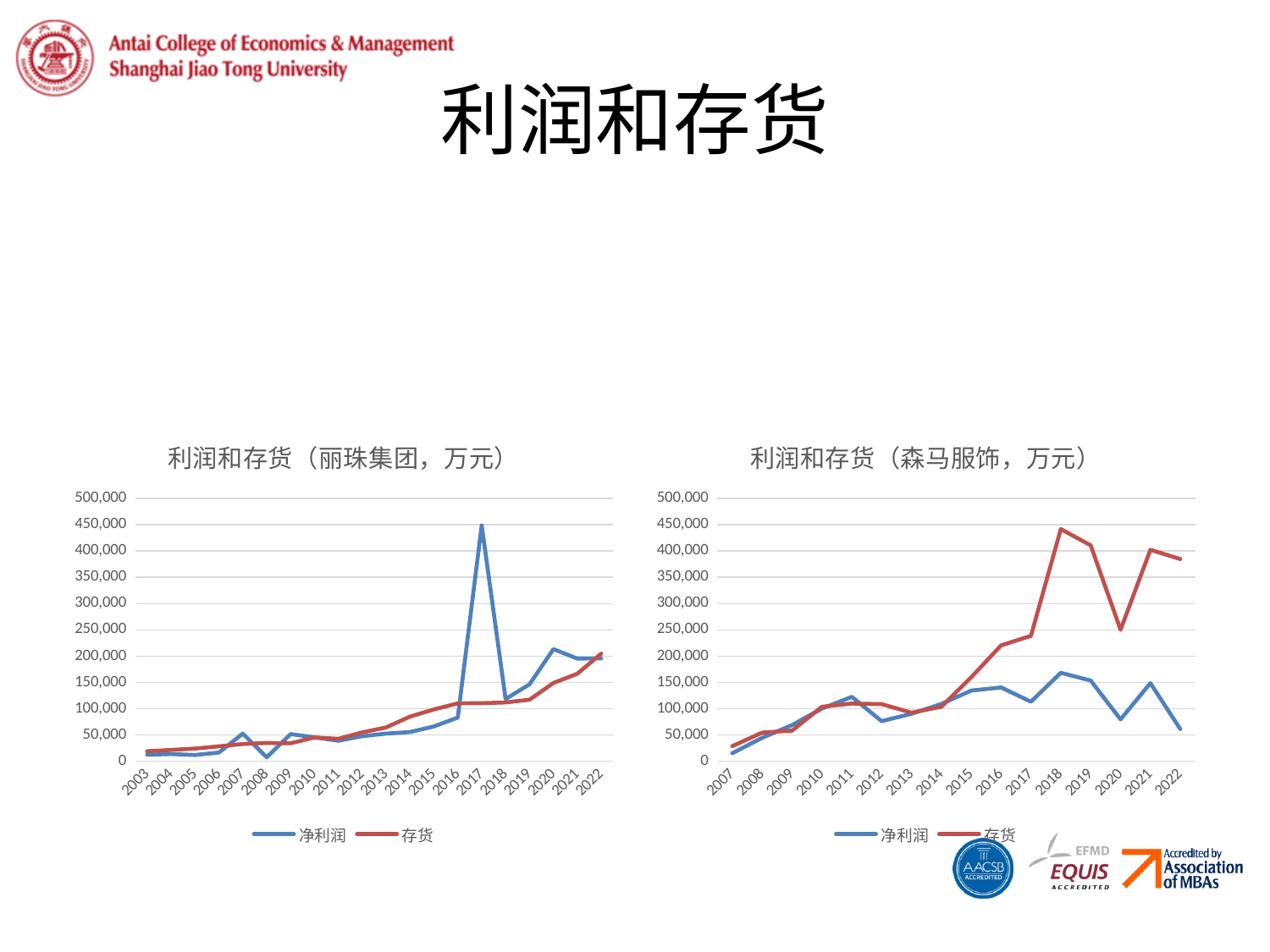
In the right chart (森马服饰), which year has the highest 存货 value? 2018 In the right chart (森马服饰), which is larger in 2022, 净利润 or 存货? 存货 In the left chart (丽珠集团), is the 净利润 value for 2017 greater or less than 400,000? greater How many years are shown on the x axis of the left chart (丽珠集团)? 20 How many series does the legend of the right chart (森马服饰) list? 2 What type of chart is the left chart titled 利润和存货（丽珠集团，万元）? line chart In the left chart (丽珠集团), which year has the highest 净利润 value? 2017 In the left chart (丽珠集团), which is larger in 2017, 净利润 or 存货? 净利润 In the left chart (丽珠集团), is the 净利润 value for 2008 greater or less than 50,000? less In the right chart (森马服饰), does the 存货 line generally rise or fall from 2007 to 2018? rise How many years are shown on the x axis of the right chart (森马服饰)? 16 In the right chart (森马服饰), is the 存货 value for 2018 greater or less than 400,000? greater